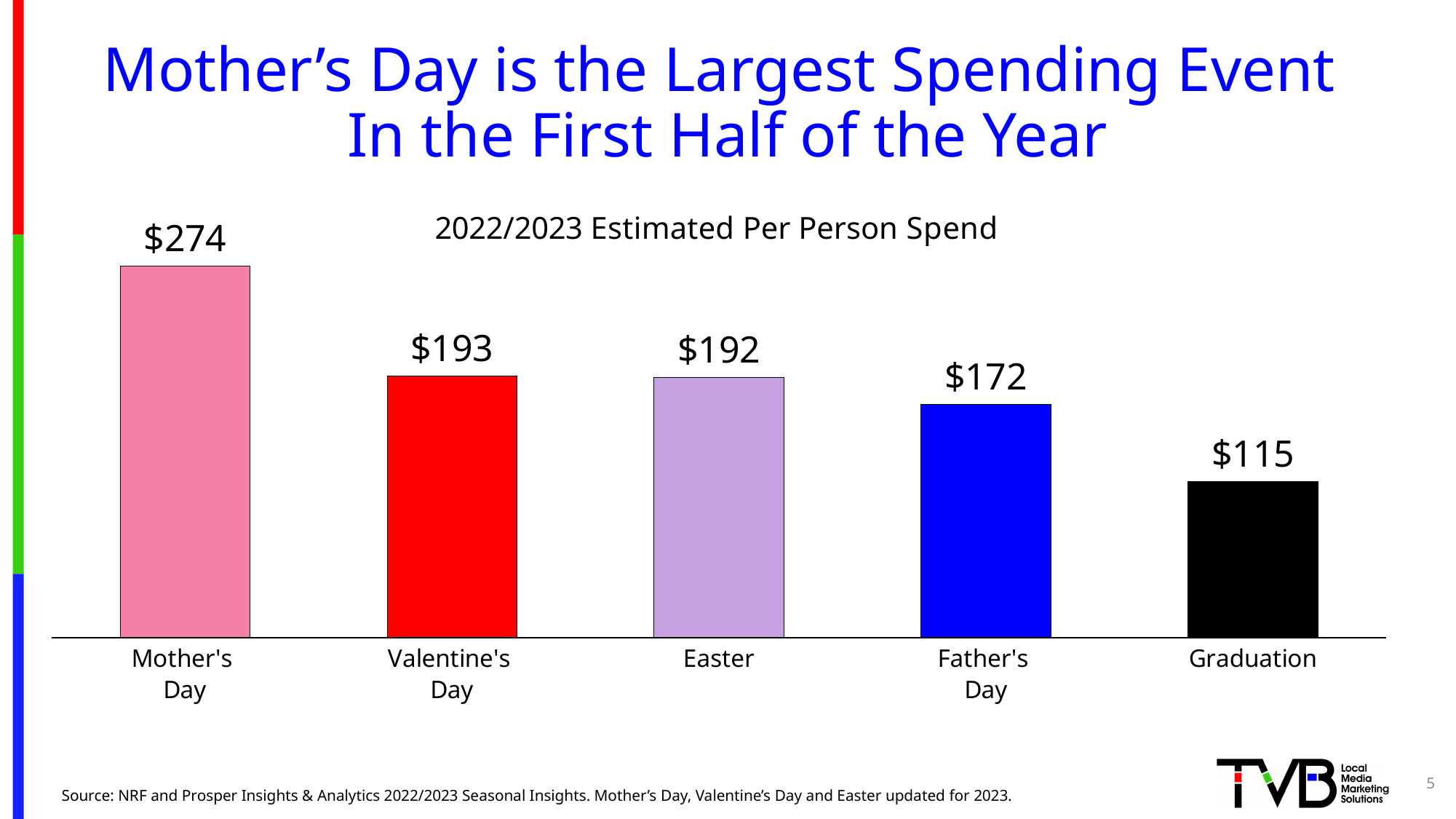
Which event has the highest estimated per person spend? Mother's Day Which event has the lowest estimated per person spend? Graduation What is the difference in per person spend between Mother's Day and Father's Day? $102 Do the values rise or fall from left to right across the chart? Fall What is the title of the chart? 2022/2023 Estimated Per Person Spend What is the estimated per person spend for Mother's Day? $274 How many events are shown in the chart? 5 What type of chart is shown on the slide? Bar chart What is the estimated per person spend for Graduation? $115 Which has a larger per person spend, Father's Day or Graduation? Father's Day What is the estimated per person spend for Father's Day? $172 What is the difference in per person spend between Valentine's Day and Easter? $1